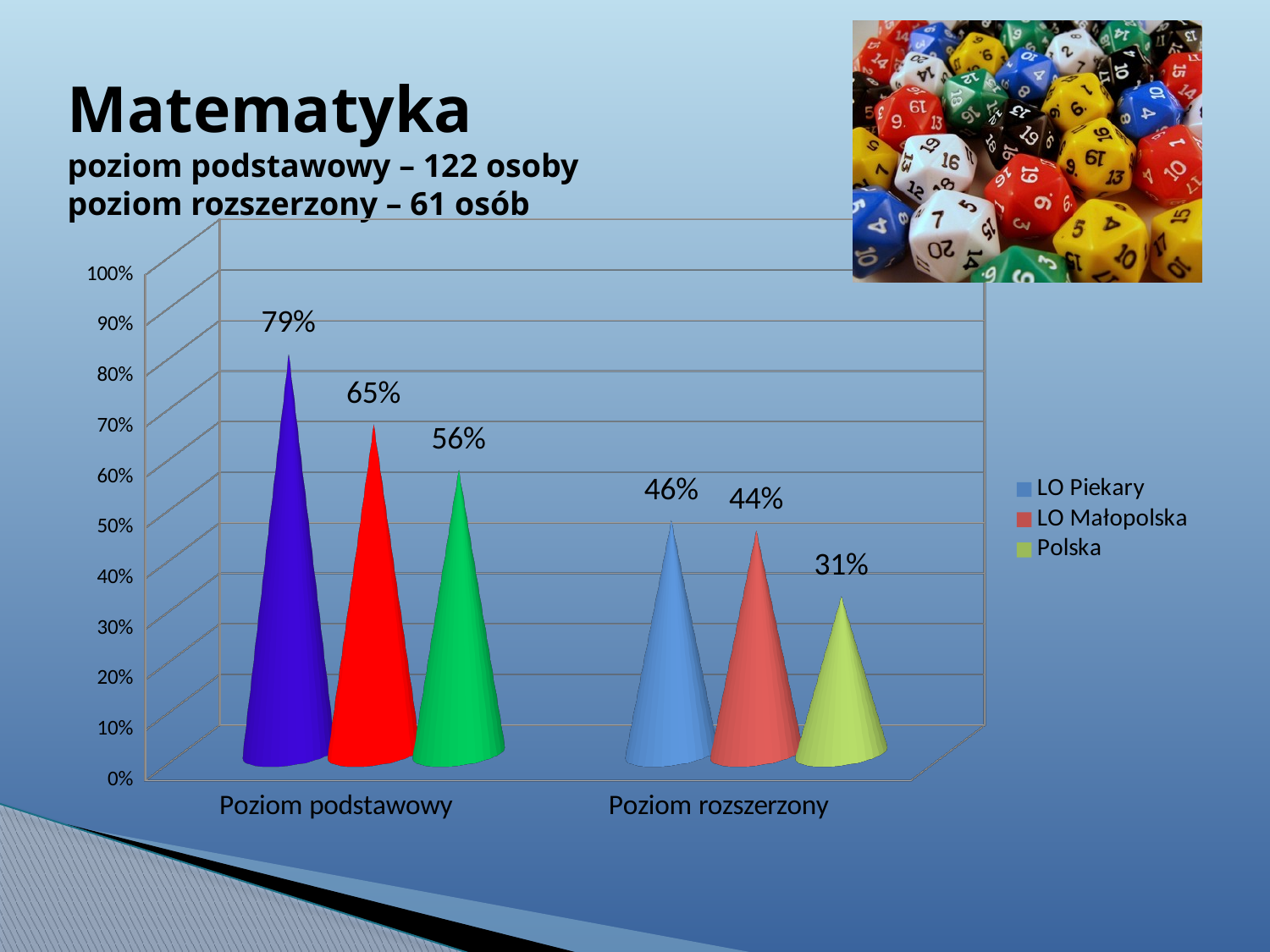
What is the value for LO Piekary at Poziom podstawowy? 79% Which series has the lowest value at Poziom rozszerzony? Polska What kind of chart is shown on the slide? Bar chart What is the value for LO Małopolska at Poziom rozszerzony? 44% Which is larger: LO Małopolska at Poziom podstawowy or LO Piekary at Poziom rozszerzony? LO Małopolska at Poziom podstawowy How many series does the legend list? 3 Which series has the highest value at Poziom podstawowy? LO Piekary What is the difference between LO Małopolska and Polska at Poziom rozszerzony? 13% How many categories are shown on the x axis? 2 What is the value for Polska at Poziom rozszerzony? 31% What is the difference between LO Piekary and Polska at Poziom podstawowy? 23% Do the values for each series rise or fall from Poziom podstawowy to Poziom rozszerzony? Fall